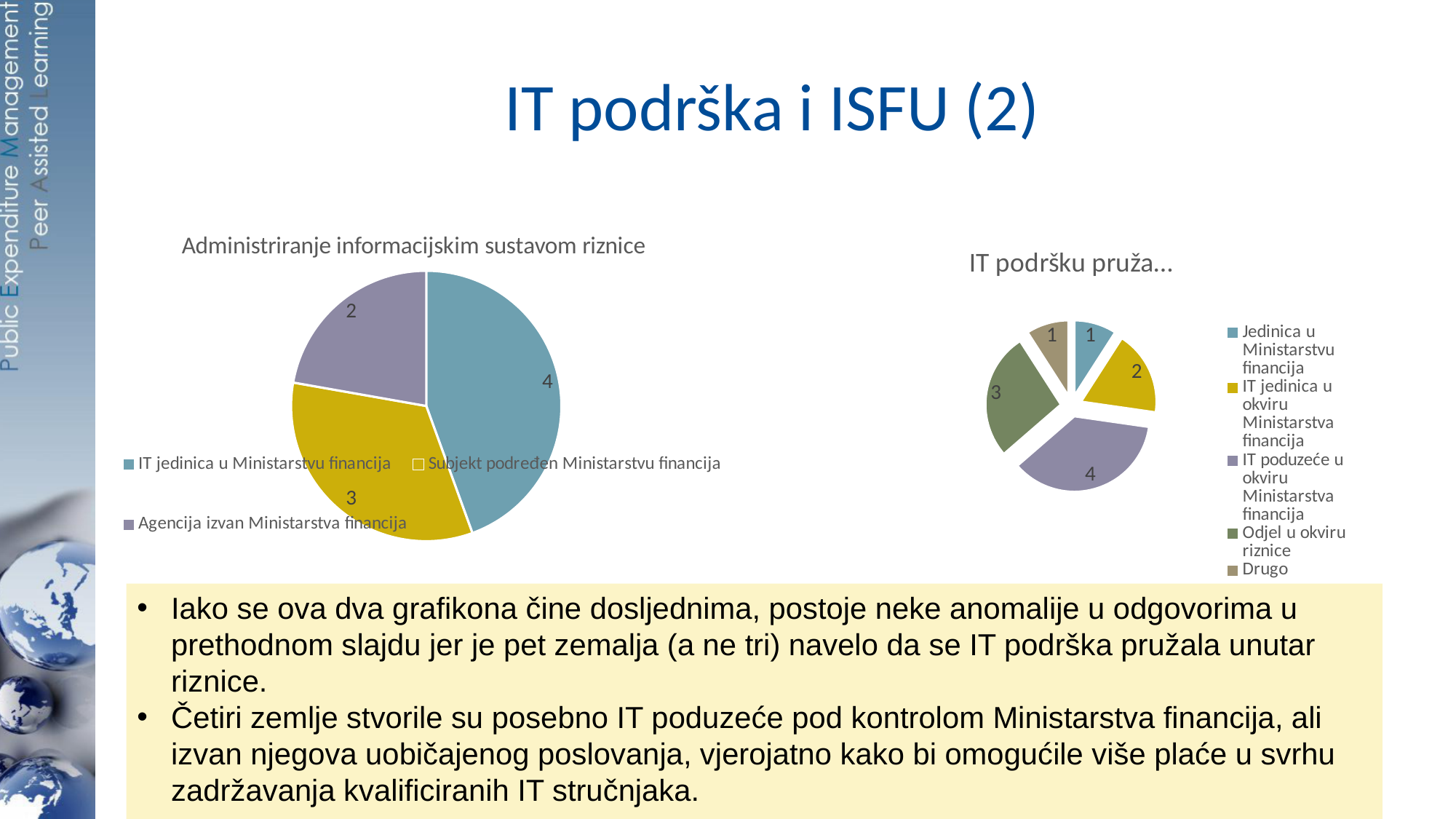
In the chart titled "IT podršku pruža...", how many categories does the legend list? 5 In the chart titled "IT podršku pruža...", which is larger: "Odjel u okviru riznice" or "Drugo"? Odjel u okviru riznice What type of chart is the one titled "IT podršku pruža..."? Pie chart In the chart titled "IT podršku pruža...", what is the difference between "IT poduzeće u okviru Ministarstva financija" and "IT jedinica u okviru Ministarstva financija"? 2 In the chart titled "IT podršku pruža...", which category has the largest slice? IT poduzeće u okviru Ministarstva financija In the chart titled "Administriranje informacijskim sustavom riznice", what is the value for "IT jedinica u Ministarstvu financija"? 4 In the chart titled "Administriranje informacijskim sustavom riznice", what is the value for "Agencija izvan Ministarstva financija"? 2 In the chart titled "IT podršku pruža...", what is the value for "Odjel u okviru riznice"? 3 In the chart titled "Administriranje informacijskim sustavom riznice", how many categories are shown? 3 In the chart titled "Administriranje informacijskim sustavom riznice", what is the total of all slices? 9 In the chart titled "Administriranje informacijskim sustavom riznice", which category has the largest slice? IT jedinica u Ministarstvu financija In the chart titled "IT podršku pruža...", what is the value for "IT poduzeće u okviru Ministarstva financija"? 4